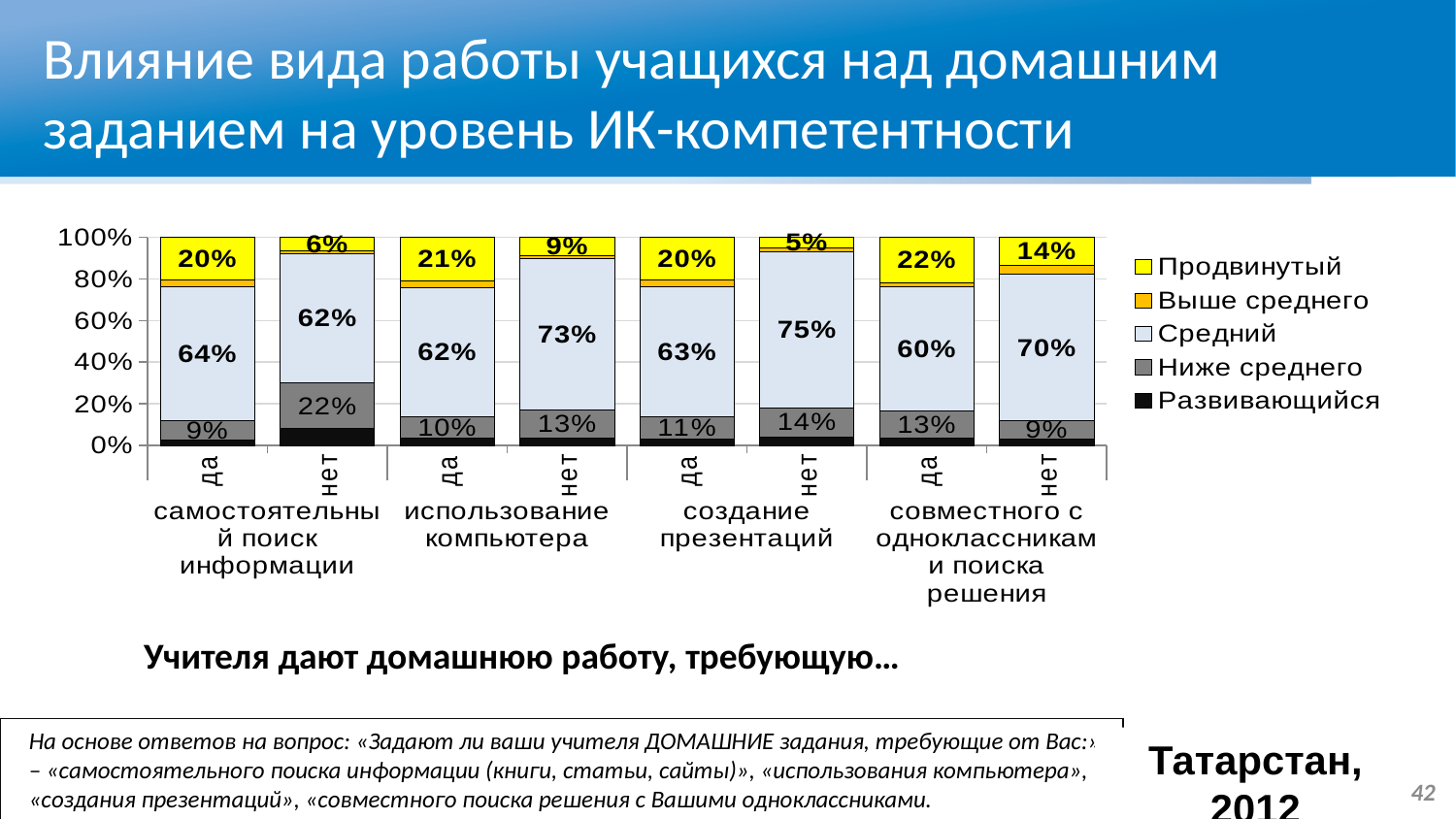
What is the value of the Средний segment for the 'да' bar under 'самостоятельный поиск информации'? 64% What is the value of the Продвинутый segment for the 'нет' bar under 'создание презентаций'? 5% What is the value of the Средний segment for the 'нет' bar under 'использование компьютера'? 73% Which bar has the lowest Продвинутый value? нет, создание презентаций What is the value of the Ниже среднего segment for the 'нет' bar under 'самостоятельный поиск информации'? 22% How many series does the legend list? 5 What is the difference between the Продвинутый values for 'да' and 'нет' under 'использование компьютера'? 12% Which bar has the highest Продвинутый value? да, совместного с одноклассниками и поиска решения How many bars are plotted in the chart? 8 Which is larger: the Средний value for 'да' or for 'нет' under 'совместного с одноклассниками и поиска решения'? нет Which legend entry is shown in yellow? Продвинутый What kind of chart is shown on the slide? stacked bar chart